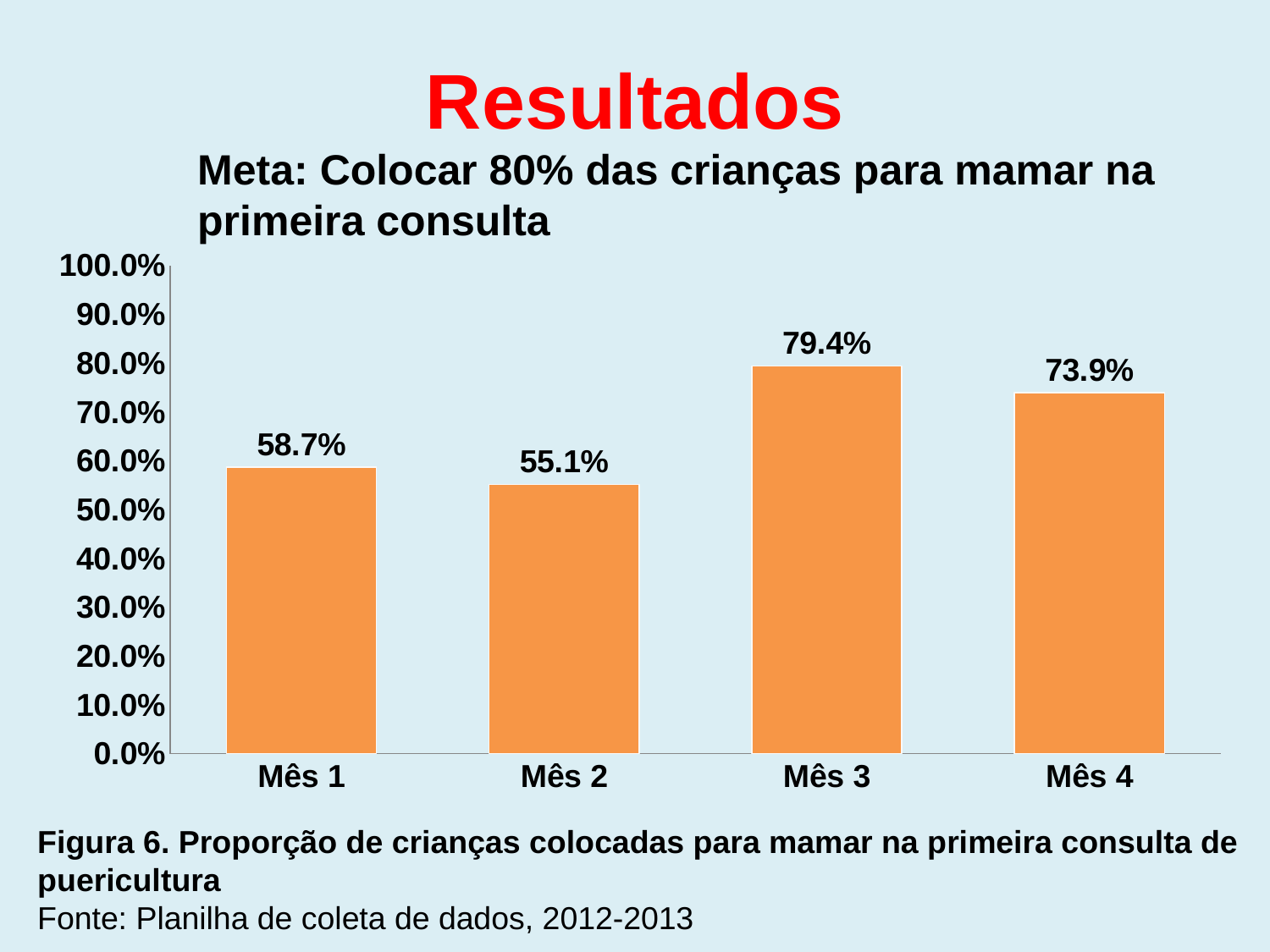
What is the difference between the values for Mês 1 and Mês 2? 3.6% What is the difference between the values for Mês 3 and Mês 2? 24.3% What is the value for Mês 3? 79.4% Is the value for Mês 3 greater or less than 80.0%? less How many months are shown on the x axis? 4 What is the value for Mês 4? 73.9% Which month has the highest value? Mês 3 Which is larger, the value for Mês 4 or the value for Mês 1? Mês 4 What kind of chart is shown on the slide? bar chart What is the figure caption below the chart? Figura 6. Proporção de crianças colocadas para mamar na primeira consulta de puericultura Which month has the lowest value? Mês 2 What is the value for Mês 1? 58.7%